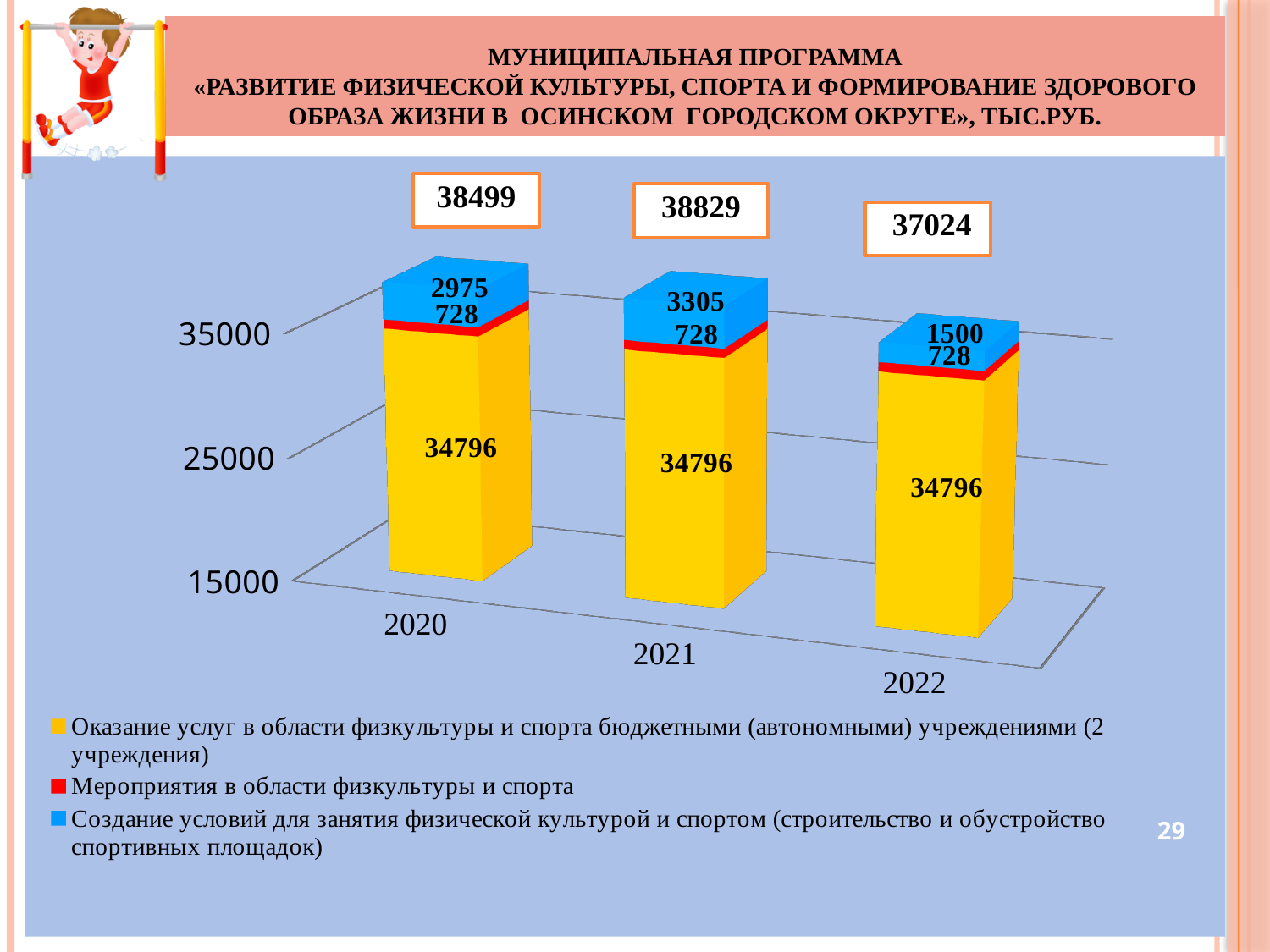
What is the difference between the blue segment values for 2020 and 2022? 1475 How many series does the legend list? 3 What is the total of the stacked bar for 2022? 37024 In which year is the blue segment (Создание условий для занятия физической культурой и спортом) the largest? 2021 Which year has the lowest total value? 2022 What is the total of the stacked bar for 2021? 38829 What type of chart is shown on the slide? stacked bar chart How many years (categories) are shown on the x axis of the chart? 3 What is the value of the yellow segment (Оказание услуг в области физкультуры и спорта) for 2020? 34796 What is the value of the red segment (Мероприятия в области физкультуры и спорта) for 2022? 728 What is the value of the blue segment (Создание условий для занятия физической культурой и спортом) for 2021? 3305 What is the value of the blue segment (Создание условий для занятия физической культурой и спортом) for 2022? 1500